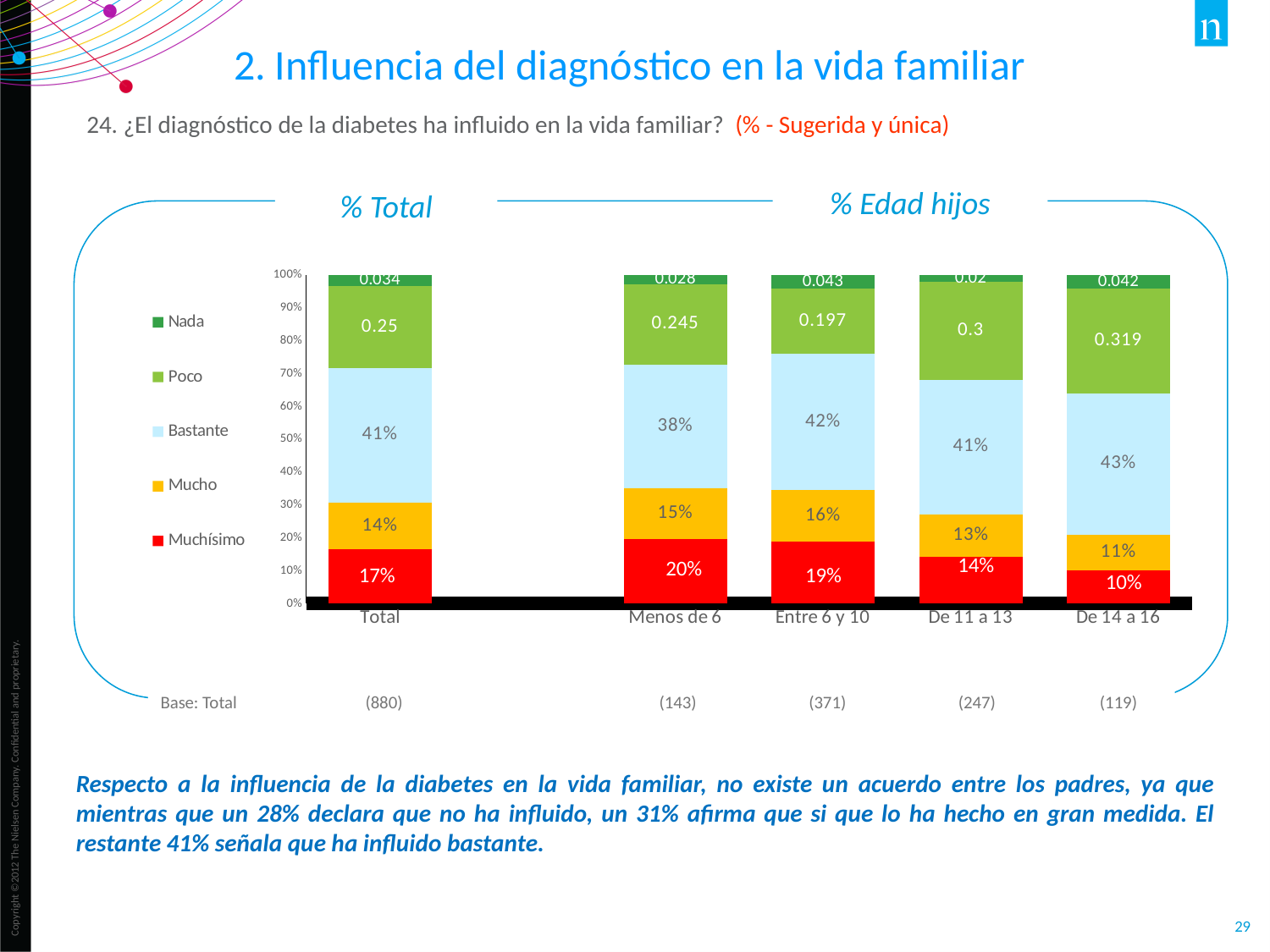
Which is larger, the Mucho value for Entre 6 y 10 or for De 14 a 16? Entre 6 y 10 What is the value of Muchísimo for the Total category? 17% What is the value of Nada for the Entre 6 y 10 category? 0.043 How many categories are shown along the x axis of the chart? 5 Which series is shown in red in the chart's legend? Muchísimo How many series does the chart's legend list? 5 Which category has the lowest value for Muchísimo? De 14 a 16 What is the value of Bastante for the De 14 a 16 category? 43% What is the difference in percentage points between the Bastante value for De 14 a 16 and for Menos de 6? 5 What kind of chart is shown on the slide? Stacked bar chart Which category has the highest value for Muchísimo? Menos de 6 What is the value of Poco for the De 11 a 13 category? 0.3